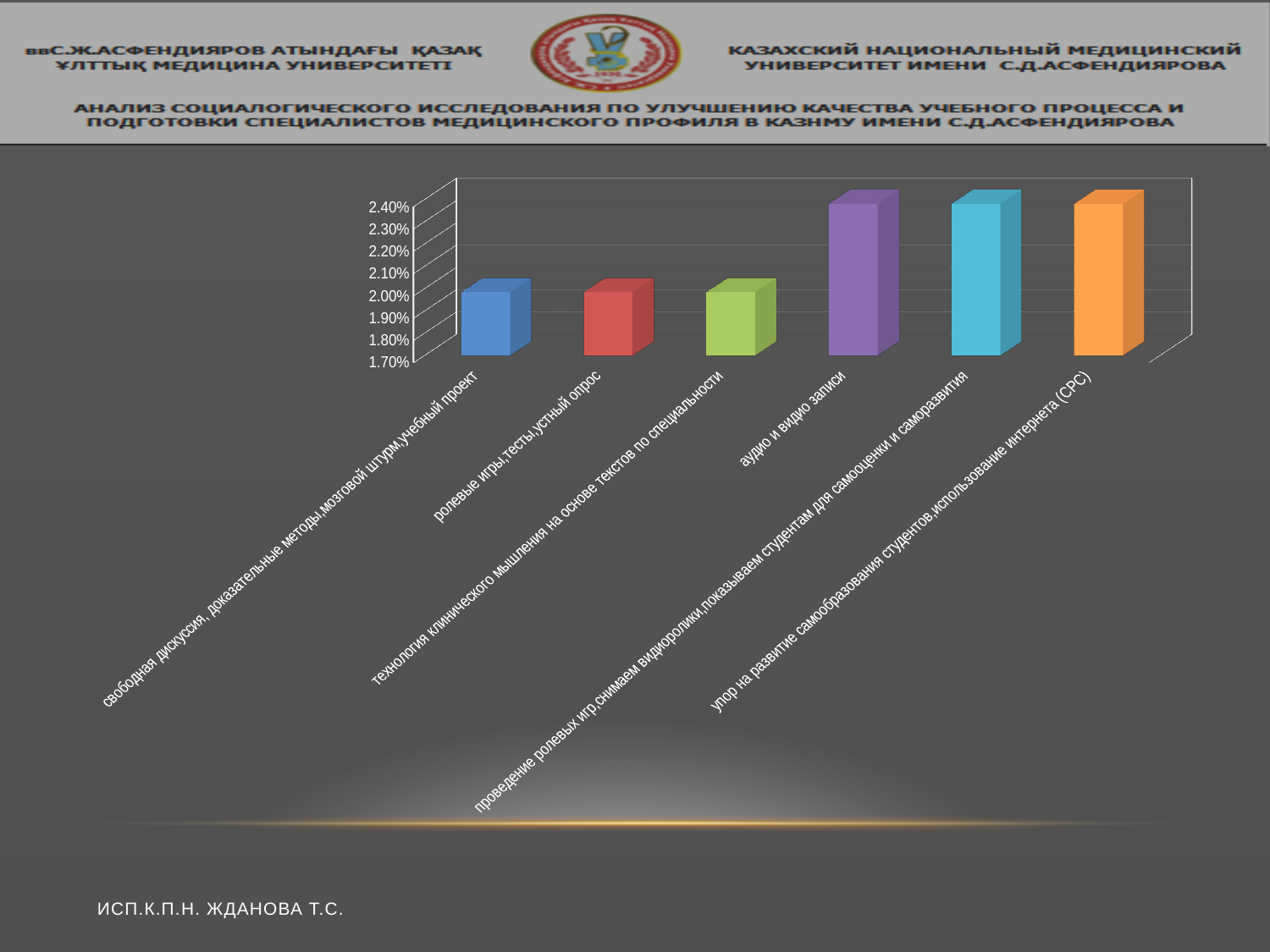
How many categories are plotted in the chart? 6 Is the value for "аудио и видио записи" greater or less than 2.20%? greater Which has the larger value: "аудио и видио записи" or "ролевые игры,тесты,устный опрос"? аудио и видио записи Is the value for "свободная дискуссия, доказательные методы,мозговой штурм,учебный проект" greater or less than 2.20%? less Is the value for "упор на развитие самообразования студентов,использование интернета (СРС)" greater or less than 2.30%? greater What colour is the bar for "аудио и видио записи"? purple Which has the larger value: "свободная дискуссия, доказательные методы,мозговой штурм,учебный проект" or "упор на развитие самообразования студентов,использование интернета (СРС)"? упор на развитие самообразования студентов,использование интернета (СРС) What kind of chart is shown on the slide? bar chart What is the lowest value shown on the vertical axis of the chart? 1.70%